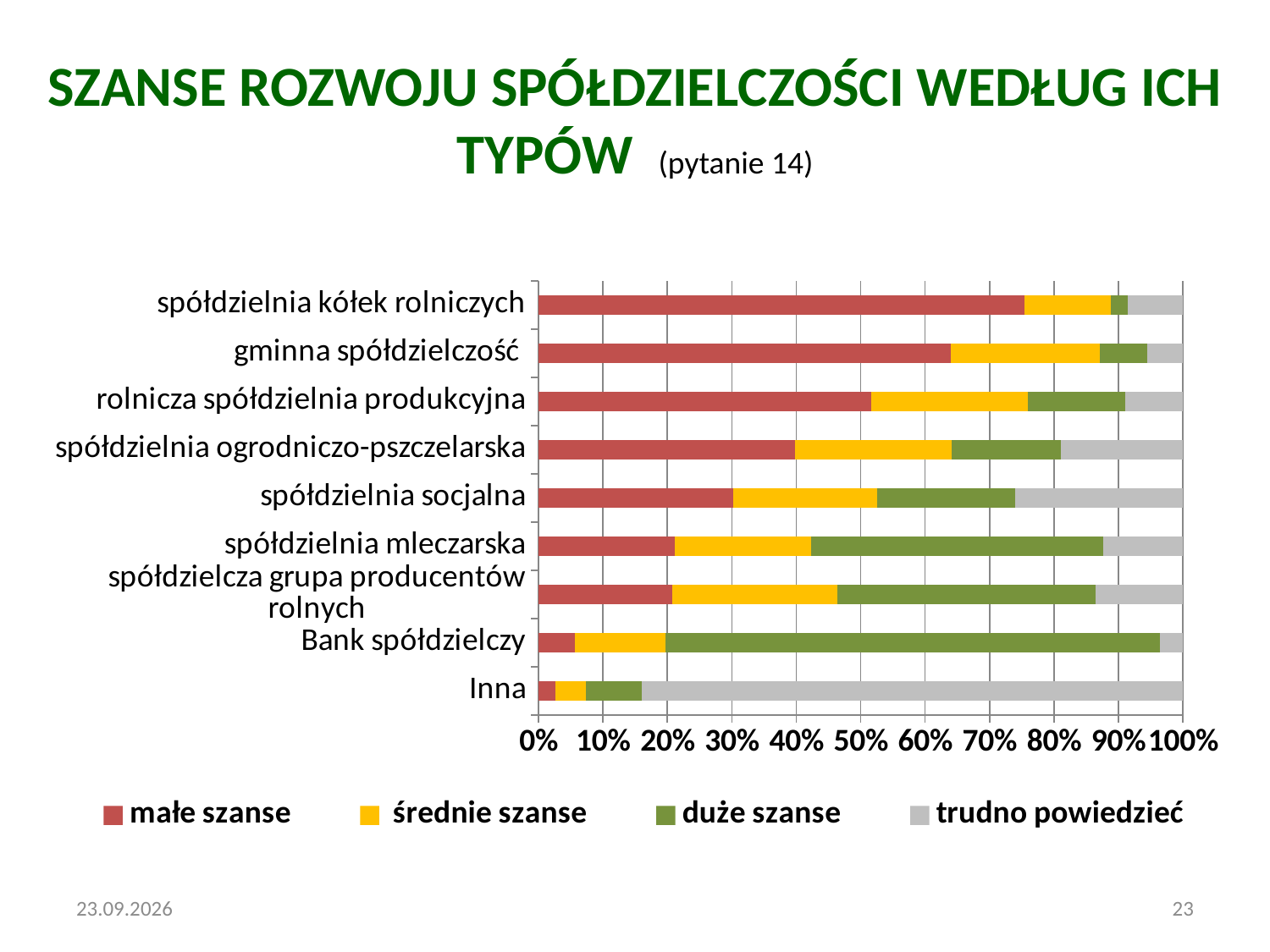
Which has a larger 'małe szanse' segment: gminna spółdzielczość or spółdzielnia socjalna? gminna spółdzielczość Which has a larger 'duże szanse' segment: Bank spółdzielczy or spółdzielnia mleczarska? Bank spółdzielczy What are the four series named in the chart legend? małe szanse, średnie szanse, duże szanse, trudno powiedzieć What kind of chart is shown on the slide? stacked bar chart How many cooperative types (categories) are listed on the vertical axis of the chart? 9 How many series does the chart legend list? 4 Which category has the largest 'małe szanse' segment? spółdzielnia kółek rolniczych Is the 'małe szanse' value for spółdzielnia kółek rolniczych greater or less than 70%? greater Which category has the largest 'trudno powiedzieć' segment? Inna Which category has the largest 'duże szanse' segment? Bank spółdzielczy Is the 'małe szanse' value for gminna spółdzielczość greater or less than 60%? greater Is the 'małe szanse' value for Bank spółdzielczy greater or less than 10%? less